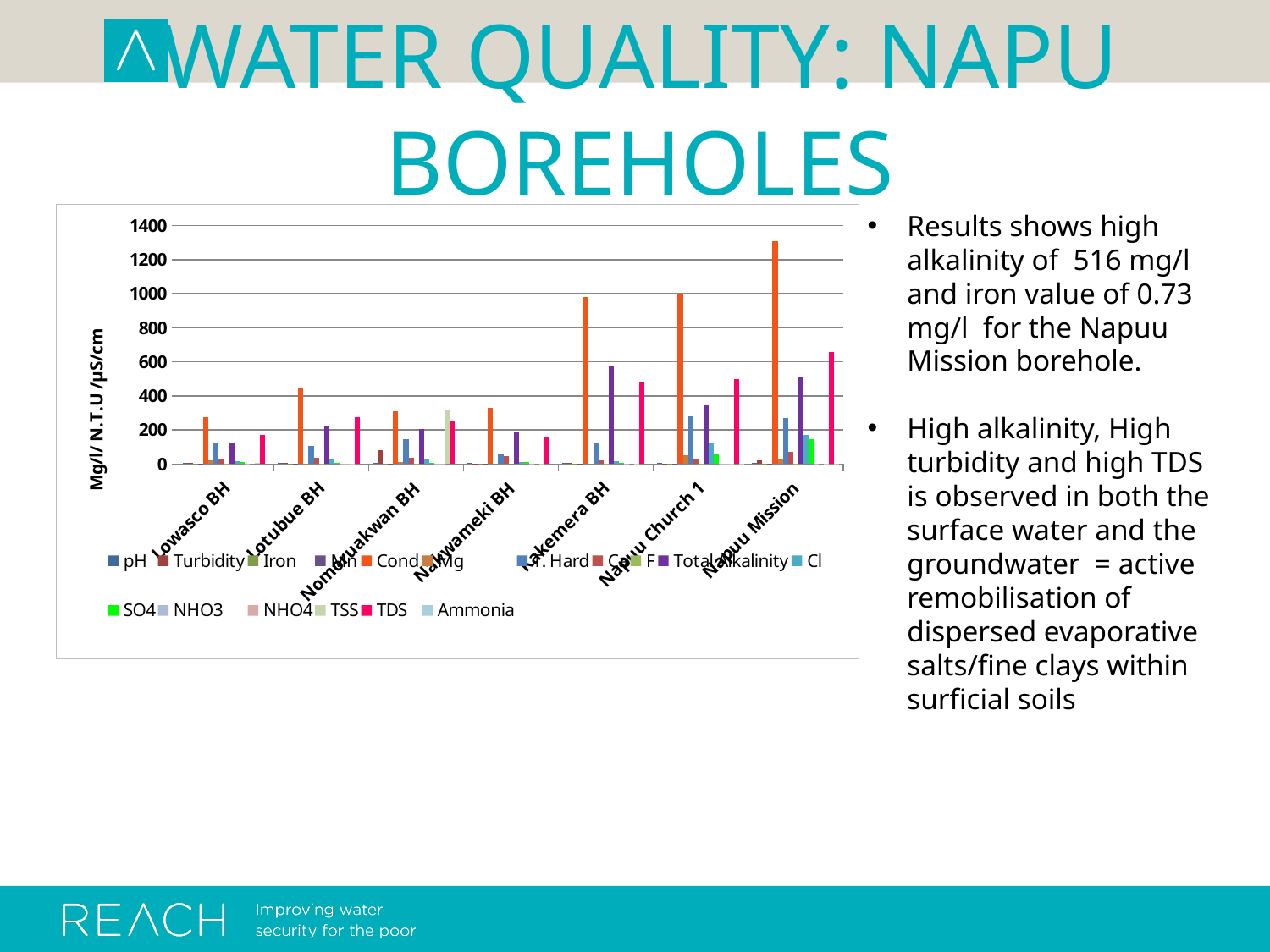
What is the y-axis label of the chart? Mg/l/ N.T.U /µS/cm How many boreholes (categories) are shown along the x axis of the chart? 7 Is the TDS value for Napuu Mission greater or less than 600? greater Which borehole has the highest Cond value in the chart? Napuu Mission Is the Cond value for Lowasco BH greater or less than 400? less How many series does the chart's legend list? 17 What kind of chart is shown on the slide? bar chart Which borehole has the highest TDS value in the chart? Napuu Mission Is the Cond value for Napuu Mission greater or less than 1200? greater